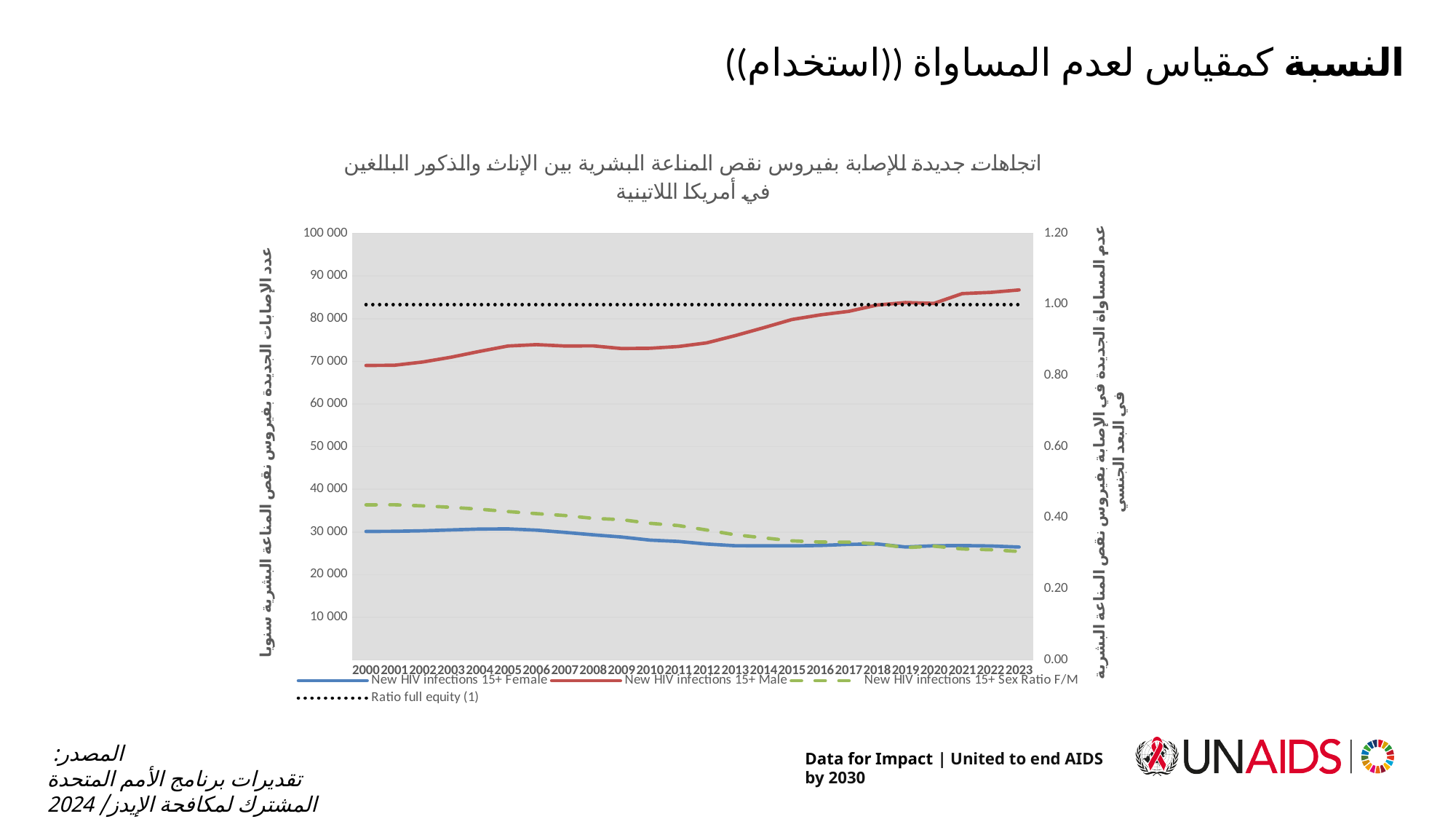
How many years are plotted along the x axis? 24 Is the value for New HIV infections 15+ Male in 2023 greater or less than 80 000? greater In 2023, which is larger: New HIV infections 15+ Male or New HIV infections 15+ Female? New HIV infections 15+ Male What is the last year shown on the x axis? 2023 How many series does the legend list? 4 What is the first year shown on the x axis? 2000 Is the New HIV infections 15+ Sex Ratio F/M in 2000 greater or less than 0.40 on the right axis? greater What kind of chart is shown on the slide? line chart Does the New HIV infections 15+ Sex Ratio F/M line rise or fall from 2000 to 2023? fall What colour is the New HIV infections 15+ Male line? red Does the New HIV infections 15+ Male line rise or fall from 2000 to 2023? rise Is the value for New HIV infections 15+ Female in 2023 greater or less than 30 000? less